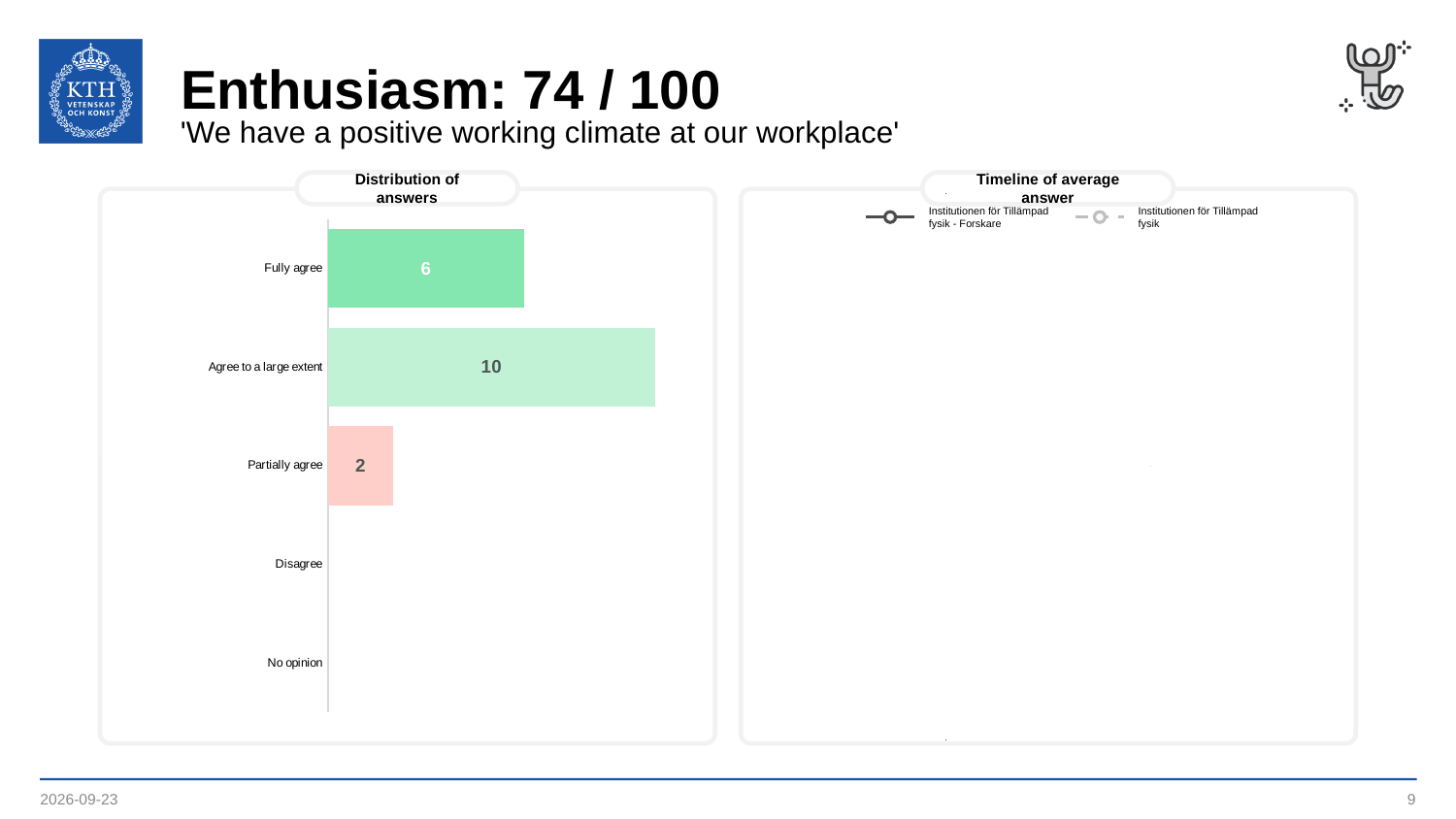
How many series does the legend of the 'Timeline of average answer' chart list? 2 In the 'Distribution of answers' chart, what is the total of the three labelled bars? 18 In the 'Distribution of answers' chart, how many respondents chose 'Fully agree'? 6 In the 'Distribution of answers' chart, which category has the highest value? Agree to a large extent How many answer categories are listed on the y axis of the 'Distribution of answers' chart? 5 In the 'Distribution of answers' chart, what is the value for 'Partially agree'? 2 In the 'Distribution of answers' chart, which is larger: 'Fully agree' or 'Partially agree'? Fully agree In the 'Distribution of answers' chart, what is the value for 'Agree to a large extent'? 10 What kind of chart is the 'Distribution of answers' chart? Bar chart In the 'Distribution of answers' chart, which labelled bar has the lowest value among the bars shown? Partially agree In the 'Distribution of answers' chart, what colour is the 'Partially agree' bar? Light red/pink In the 'Distribution of answers' chart, what is the difference between 'Agree to a large extent' and 'Fully agree'? 4